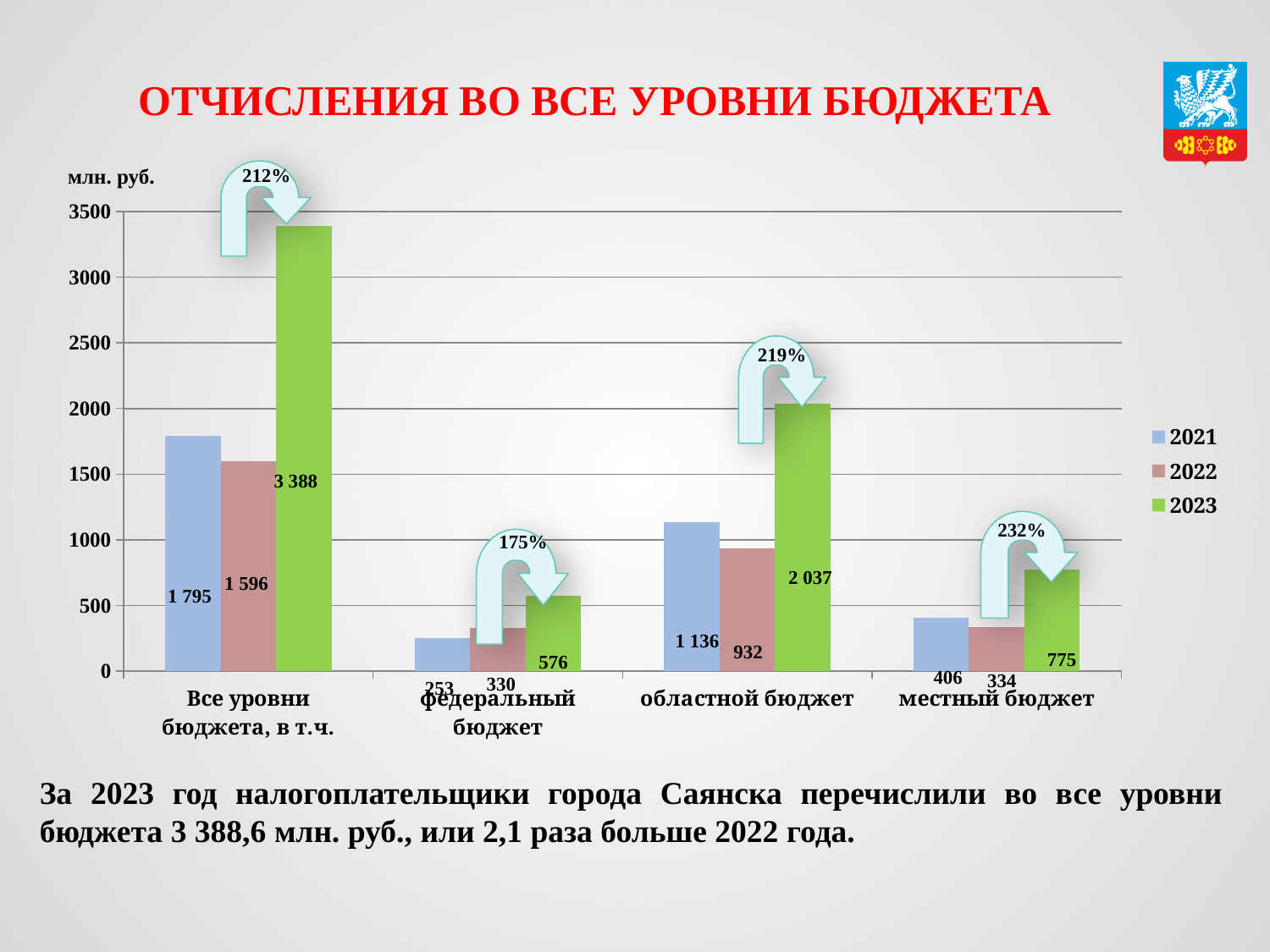
What percentage is shown in the arrow above the "местный бюджет" bars? 232% What is the 2021 value for "местный бюджет"? 406 Is the 2023 value for "Все уровни бюджета, в т.ч." greater or less than 3000? greater How many categories are shown on the x axis? 4 Which is larger for "федеральный бюджет": the 2021 value or the 2022 value? 2022 What kind of chart is shown on the slide? bar chart What is the 2022 value for "областной бюджет"? 932 How many series does the legend list? 3 What is the 2023 value for "федеральный бюджет"? 576 What is the difference between the 2023 and 2022 values for "областной бюджет"? 1 105 Which category has the lowest 2023 value? федеральный бюджет What is the 2023 value for "Все уровни бюджета, в т.ч."? 3 388